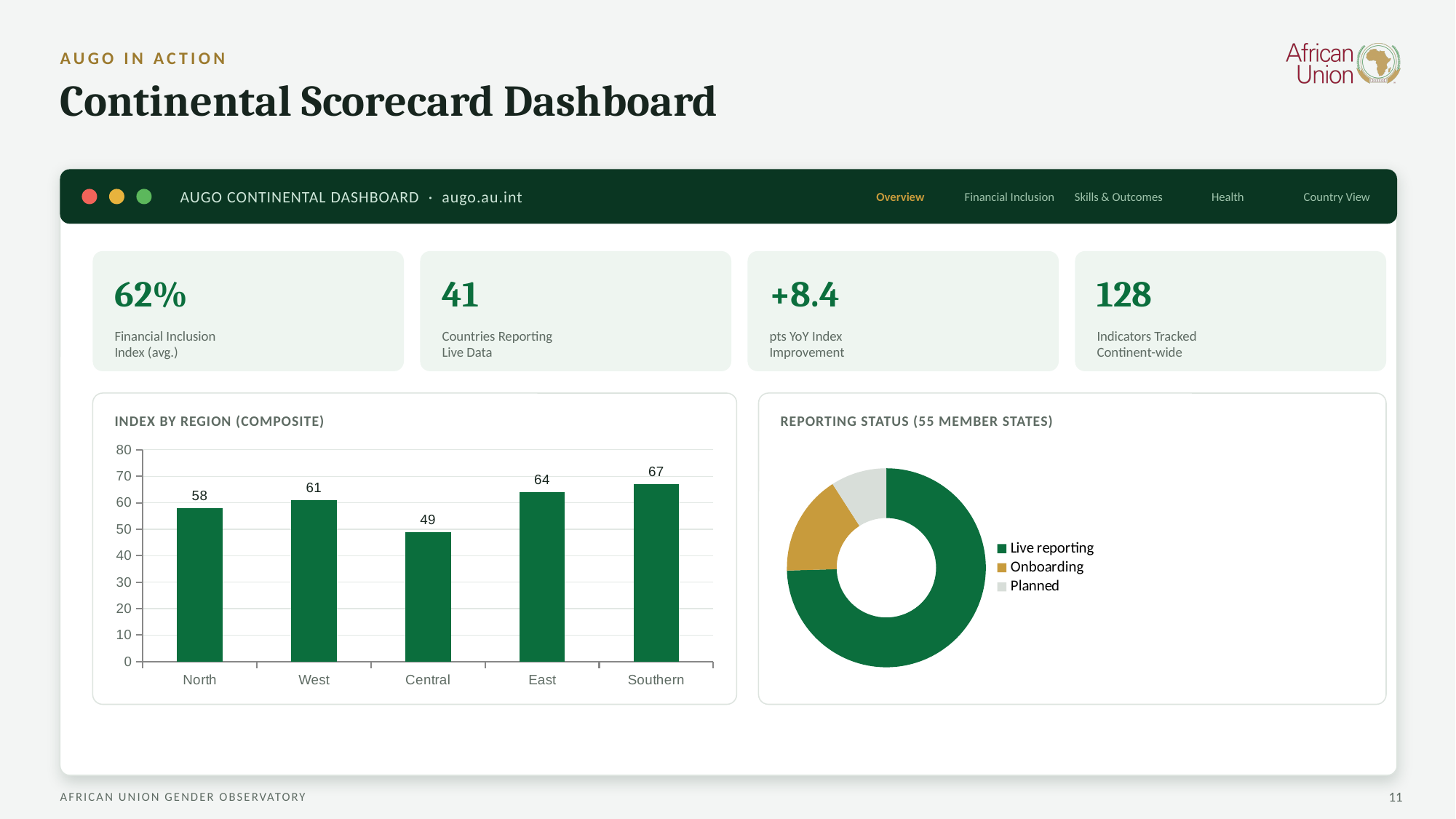
In the 'Reporting Status (55 Member States)' chart, which category has the largest share? Live reporting In the 'Index by Region (Composite)' chart, is the value for East greater or less than 60? greater In the 'Index by Region (Composite)' chart, what is the difference between the values for Southern and Central? 18 In the 'Index by Region (Composite)' chart, what is the value for Central? 49 In the 'Index by Region (Composite)' chart, what is the value for North? 58 In the 'Index by Region (Composite)' chart, which region has the lowest value? Central In the 'Index by Region (Composite)' chart, which region has the highest value? Southern In the 'Reporting Status (55 Member States)' chart, which category is shown in gold? Onboarding In the 'Index by Region (Composite)' chart, how many regions are shown? 5 In the 'Index by Region (Composite)' chart, which is larger, the value for West or the value for East? East In the 'Reporting Status (55 Member States)' chart, how many categories does the legend list? 3 What kind of chart is 'Index by Region (Composite)'? Bar chart